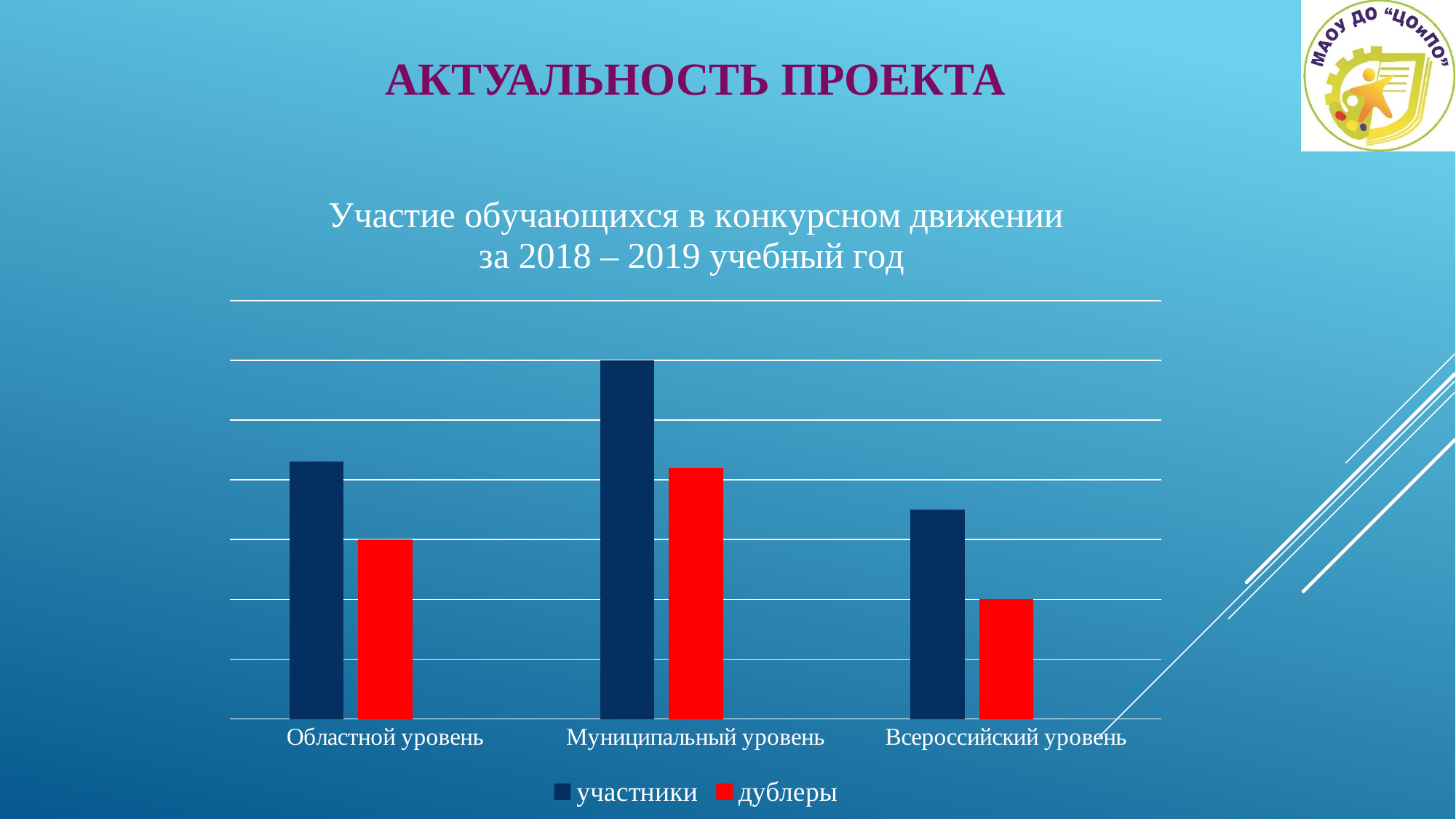
Which is larger: дублеры for Муниципальный уровень or участники for Всероссийский уровень? дублеры for Муниципальный уровень What is the title of the chart? Участие обучающихся в конкурсном движении за 2018 – 2019 учебный год Which colour represents the дублеры series in the legend? red Which category has the highest value for участники? Муниципальный уровень Which category has the highest value for дублеры? Муниципальный уровень How many categories are shown on the x axis? 3 What kind of chart is shown on the slide? bar chart How many series does the legend list? 2 Which category has the lowest value for участники? Всероссийский уровень Which category has the lowest value for дублеры? Всероссийский уровень For Областной уровень, which is larger: участники or дублеры? участники For Всероссийский уровень, which is larger: участники or дублеры? участники